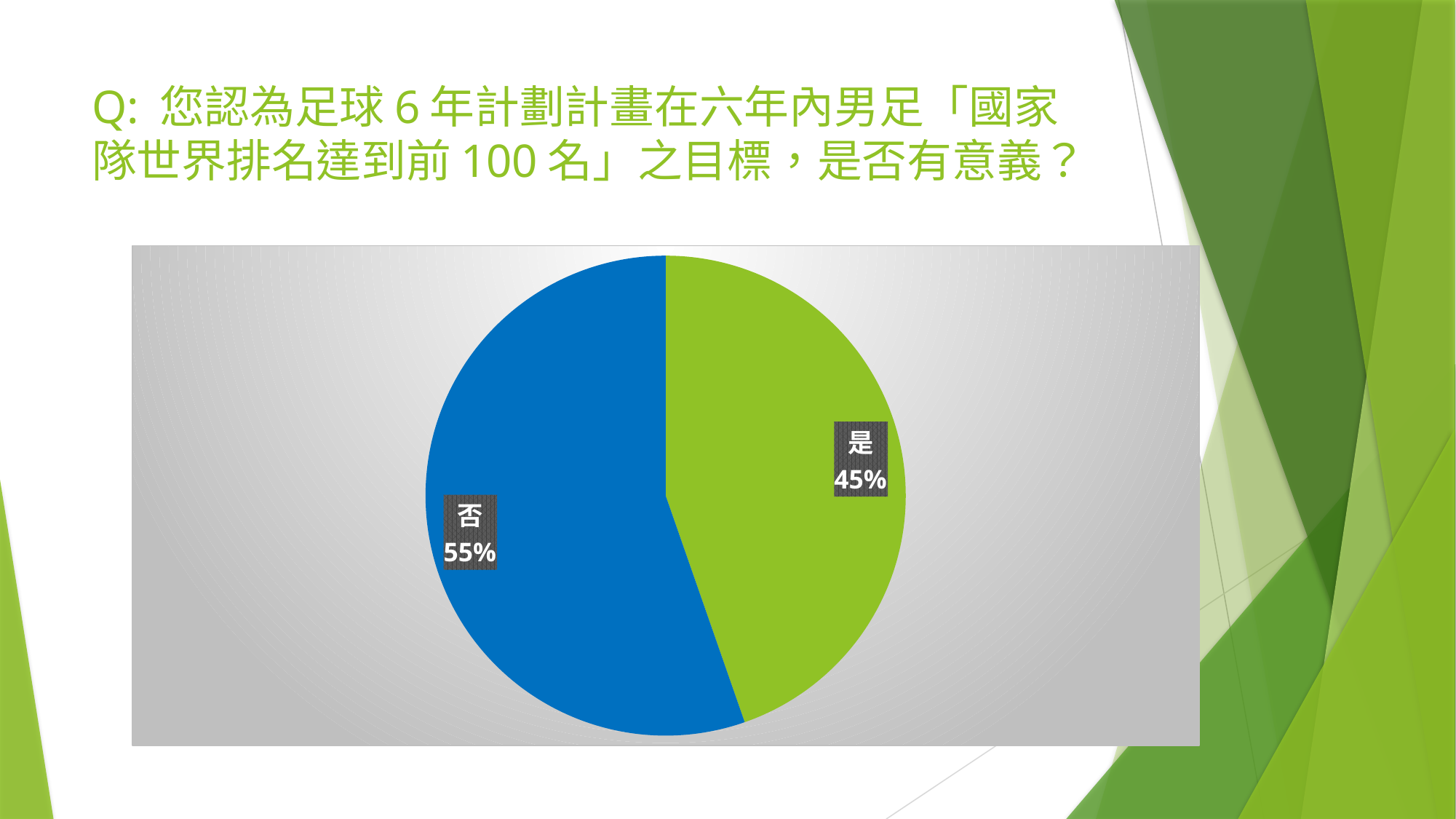
What is the difference between the 否 and 是 shares? 10% Which slice is the largest in the pie chart? 否 How many slices does the pie chart have? 2 Which slice is the smallest in the pie chart? 是 What percentage of respondents answered 否? 55% What kind of chart is shown on the slide? pie chart What colour is the 是 slice? green What colour is the 否 slice? blue Which is larger, the share for 是 or the share for 否? 否 What percentage of respondents answered 是? 45% What share of the pie does the 是 slice represent? 45%